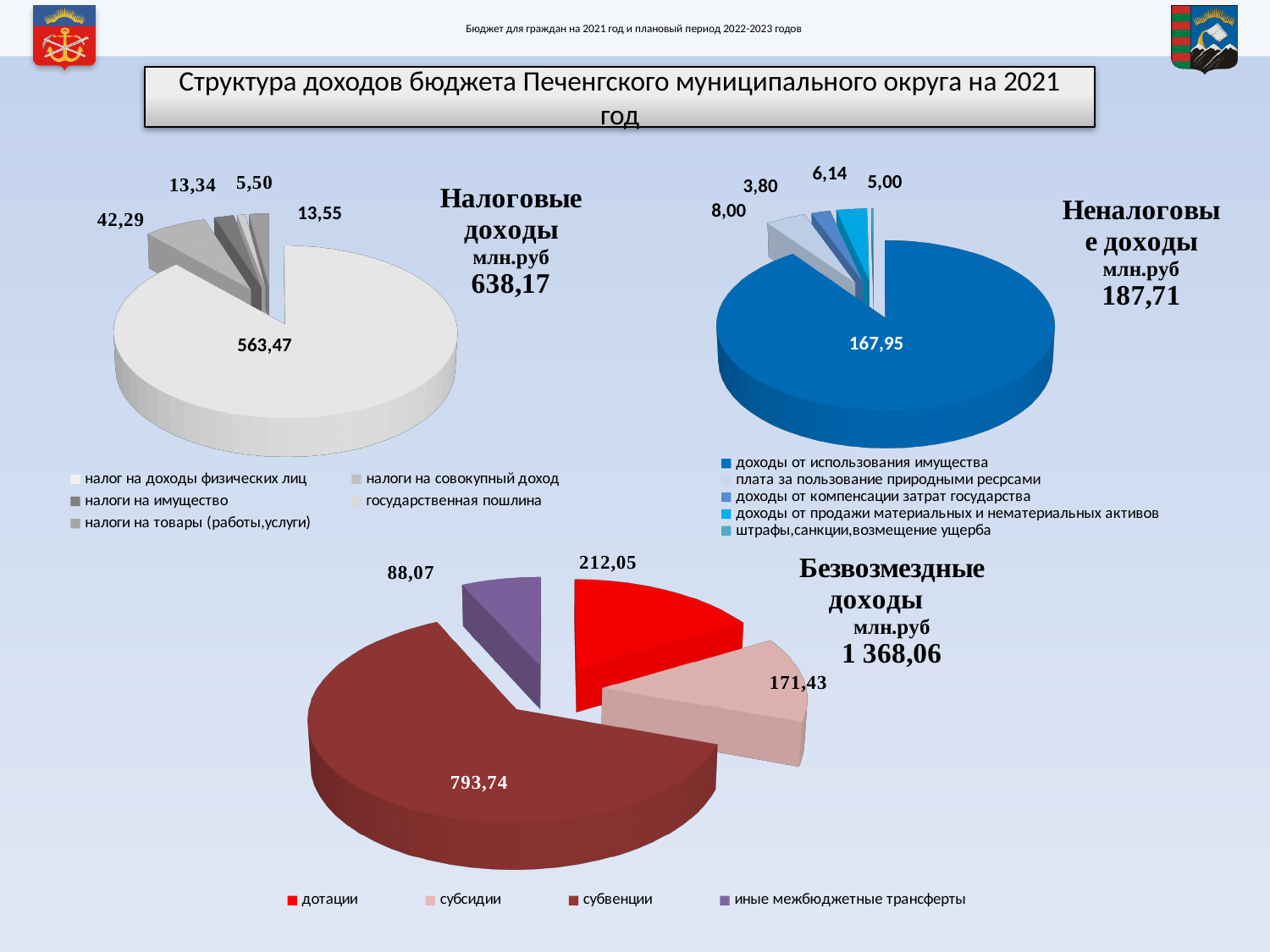
On the 'Безвозмездные доходы' pie chart, which category has the smallest value? иные межбюджетные трансферты On the 'Безвозмездные доходы' pie chart, what is the difference between the values for дотации and субсидии? 40,62 How many categories does the 'Безвозмездные доходы' pie chart show? 4 On the 'Безвозмездные доходы' pie chart, which is larger: дотации or субсидии? дотации On the 'Безвозмездные доходы' pie chart, which category has the largest value? субвенции On the 'Неналоговые доходы' pie chart, what is the value for доходы от использования имущества? 167,95 On the 'Безвозмездные доходы' pie chart, what is the value for субвенции? 793,74 On the 'Безвозмездные доходы' pie chart, what is the value for дотации? 212,05 What total in млн.руб is shown next to the 'Неналоговые доходы' chart? 187,71 On the 'Безвозмездные доходы' pie chart, what is the value for иные межбюджетные трансферты? 88,07 What kind of chart is used for 'Налоговые доходы'? pie chart On the 'Налоговые доходы' pie chart, what is the value for налог на доходы физических лиц? 563,47